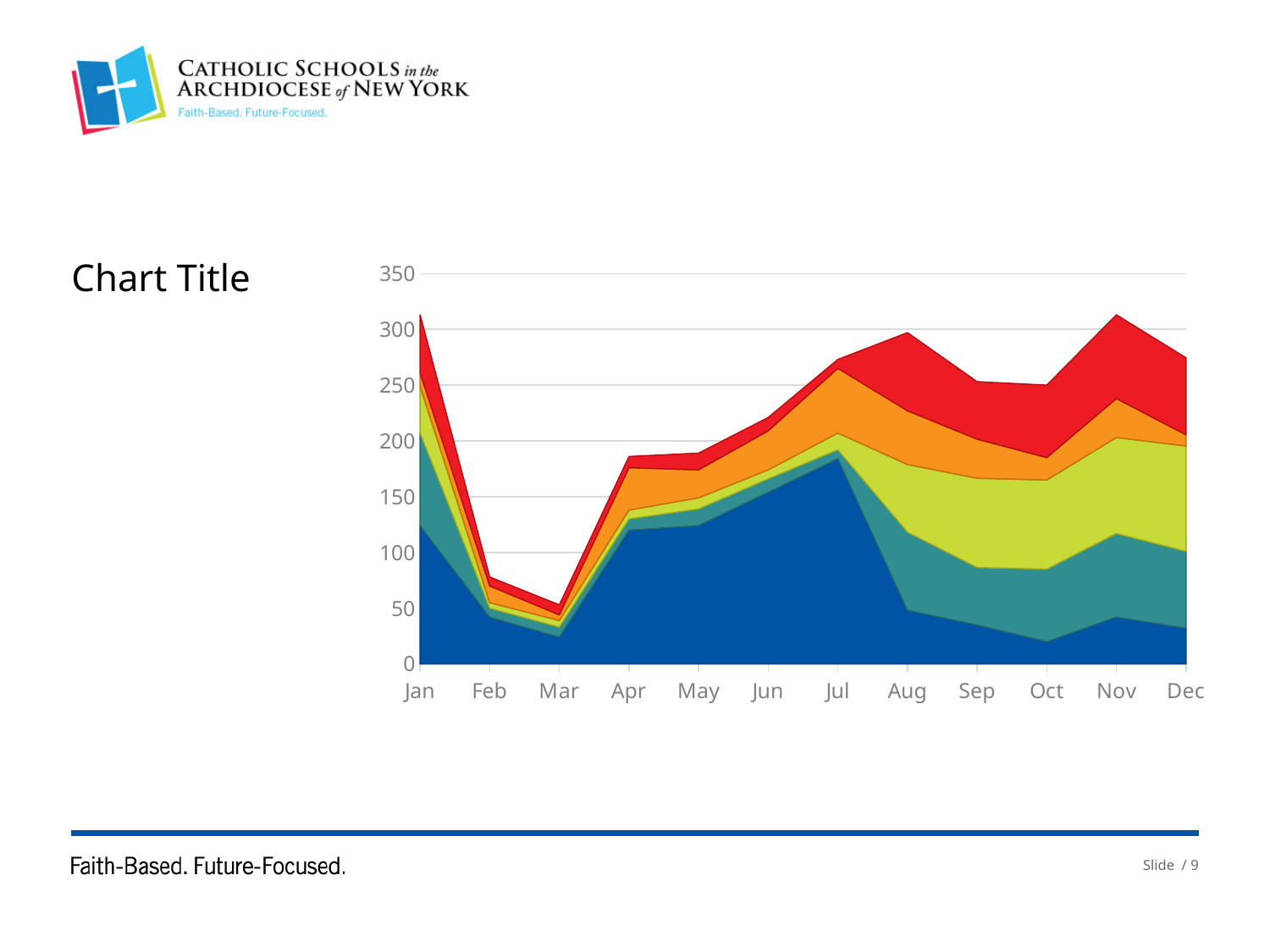
Is the value of the bottom (dark blue) series for Jul greater or less than 150? greater Is the stacked total for Jan greater or less than 300? greater Which month has the lowest stacked total in the chart? Mar How many coloured series bands are stacked in the chart? 5 Which month has the larger stacked total, Aug or Sep? Aug Does the stacked total rise or fall from Mar to Jul? rise What kind of chart is shown on the slide? Stacked area chart In which month does the bottom (dark blue) series reach its highest value? Jul Is the stacked total for Mar greater or less than 100? less How many months are shown along the x axis of the chart? 12 What is the title of the chart? Chart Title